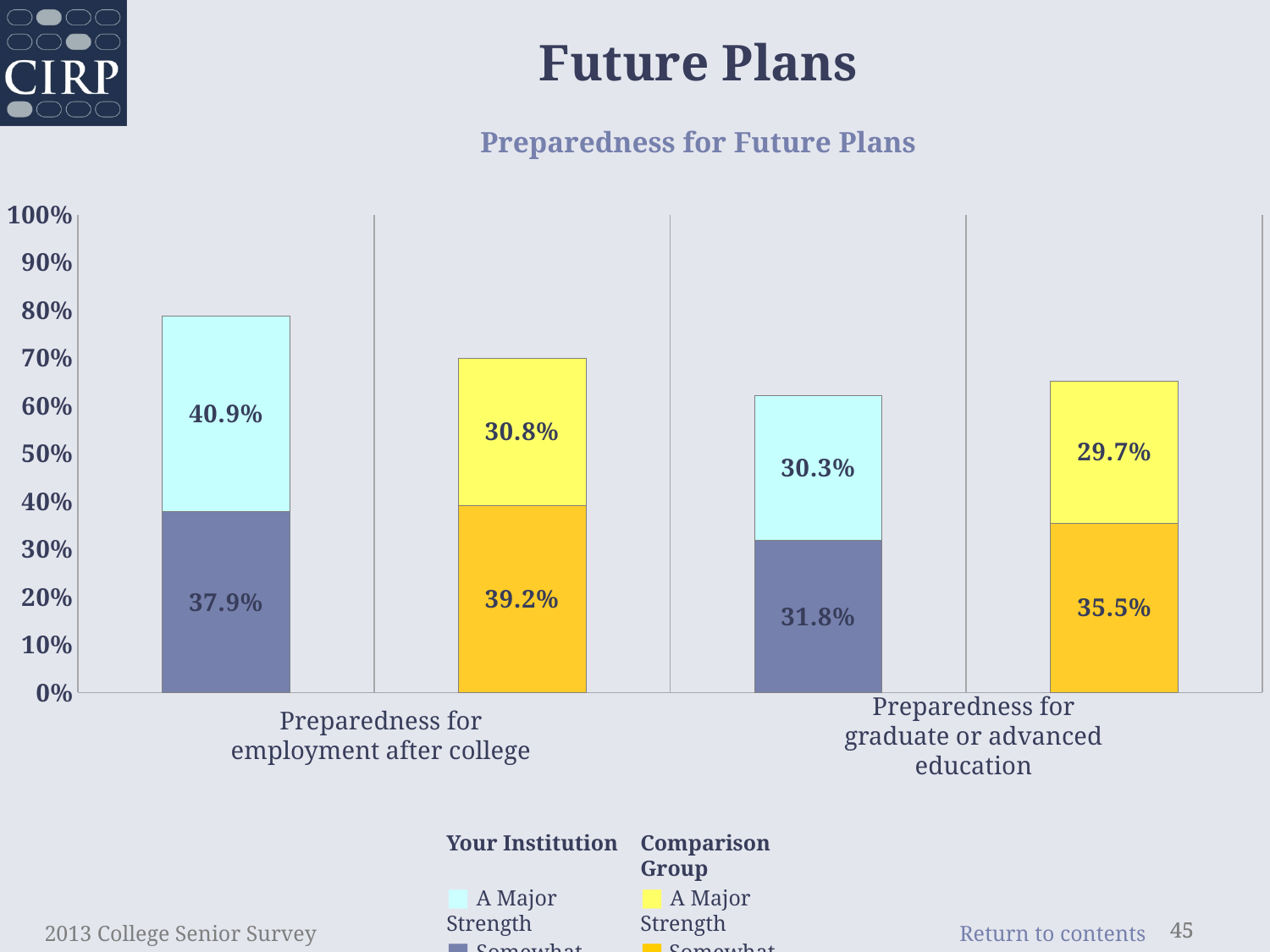
What is the total height of the Your Institution stacked bar for preparedness for employment after college? 78.8% How many categories are shown along the x axis of the chart? 2 For preparedness for employment after college, how much larger is the 'A Major Strength' value for Your Institution than for the Comparison Group? 10.1 percentage points What percentage of Your Institution respondents rated preparedness for employment after college as 'A Major Strength'? 40.9% What is the title of the chart? Preparedness for Future Plans What kind of chart is shown on the slide? Stacked bar chart What is the 'A Major Strength' value for the Comparison Group for preparedness for graduate or advanced education? 29.7% What is the 'A Major Strength' value for Your Institution for preparedness for graduate or advanced education? 30.3% For preparedness for graduate or advanced education, which has the larger lower (Somewhat) segment: Your Institution or the Comparison Group? Comparison Group What is the total height of the Comparison Group stacked bar for preparedness for graduate or advanced education? 65.2% What is the value of the lower (Somewhat) segment of the Comparison Group bar for preparedness for employment after college? 39.2% Which bar has the highest 'A Major Strength' value on the chart? Your Institution, preparedness for employment after college (40.9%)